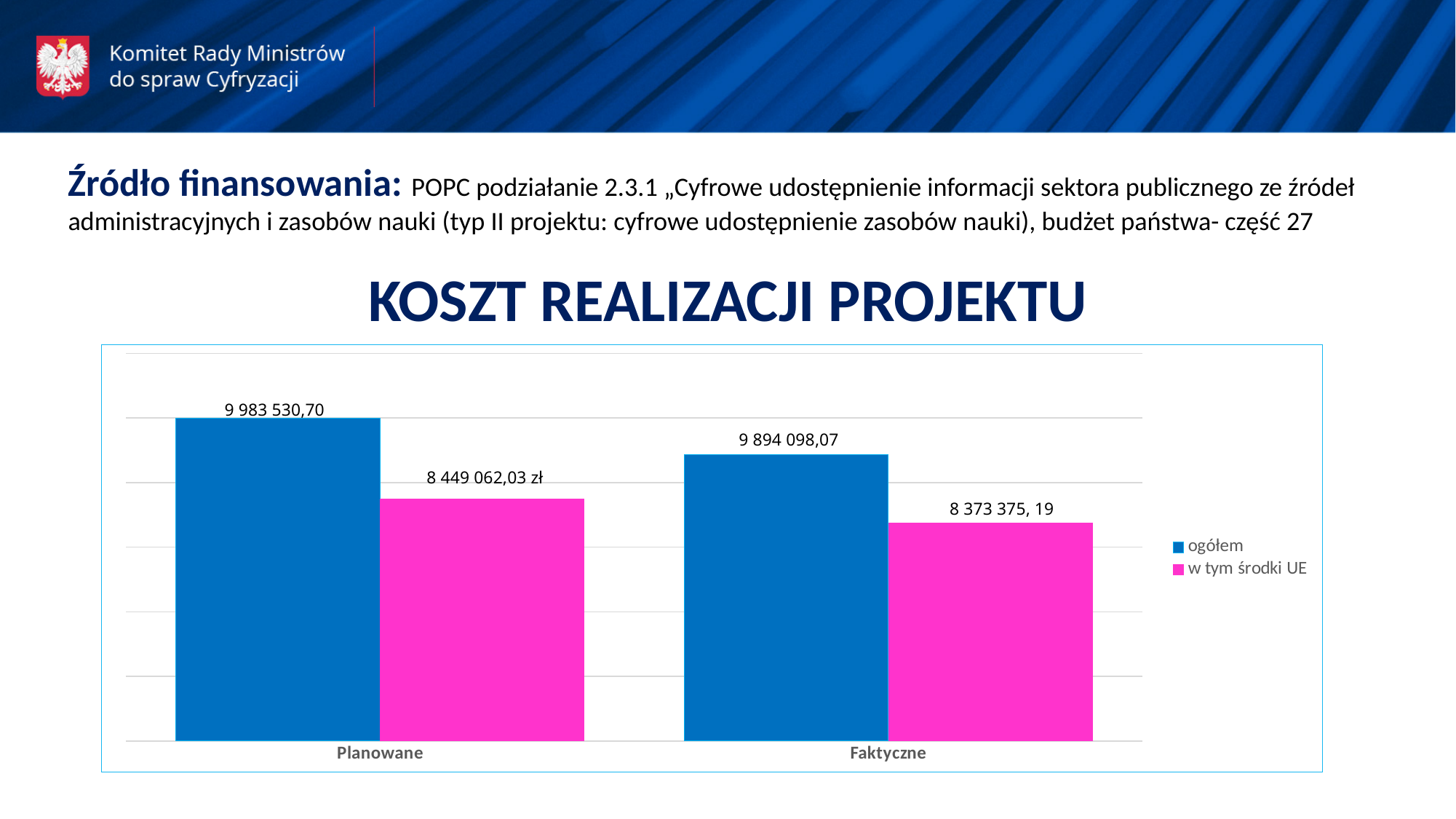
What is the difference between the "ogółem" and "w tym środki UE" values for Faktyczne? 1 520 722,88 What is the value of the "w tym środki UE" bar for Planowane? 8 449 062,03 zł Which bar in the chart has the lowest value? w tym środki UE for Faktyczne What is the value of the "ogółem" bar for Planowane? 9 983 530,70 Which is larger: the "ogółem" value for Planowane or for Faktyczne? Planowane How many categories are shown on the x axis of the chart? 2 What is the value of the "ogółem" bar for Faktyczne? 9 894 098,07 Which bar in the chart has the highest value? ogółem for Planowane What is the difference between the "ogółem" values for Planowane and Faktyczne? 89 432,63 What type of chart is shown on the slide? bar chart What is the value of the "w tym środki UE" bar for Faktyczne? 8 373 375, 19 How many series does the chart legend list? 2